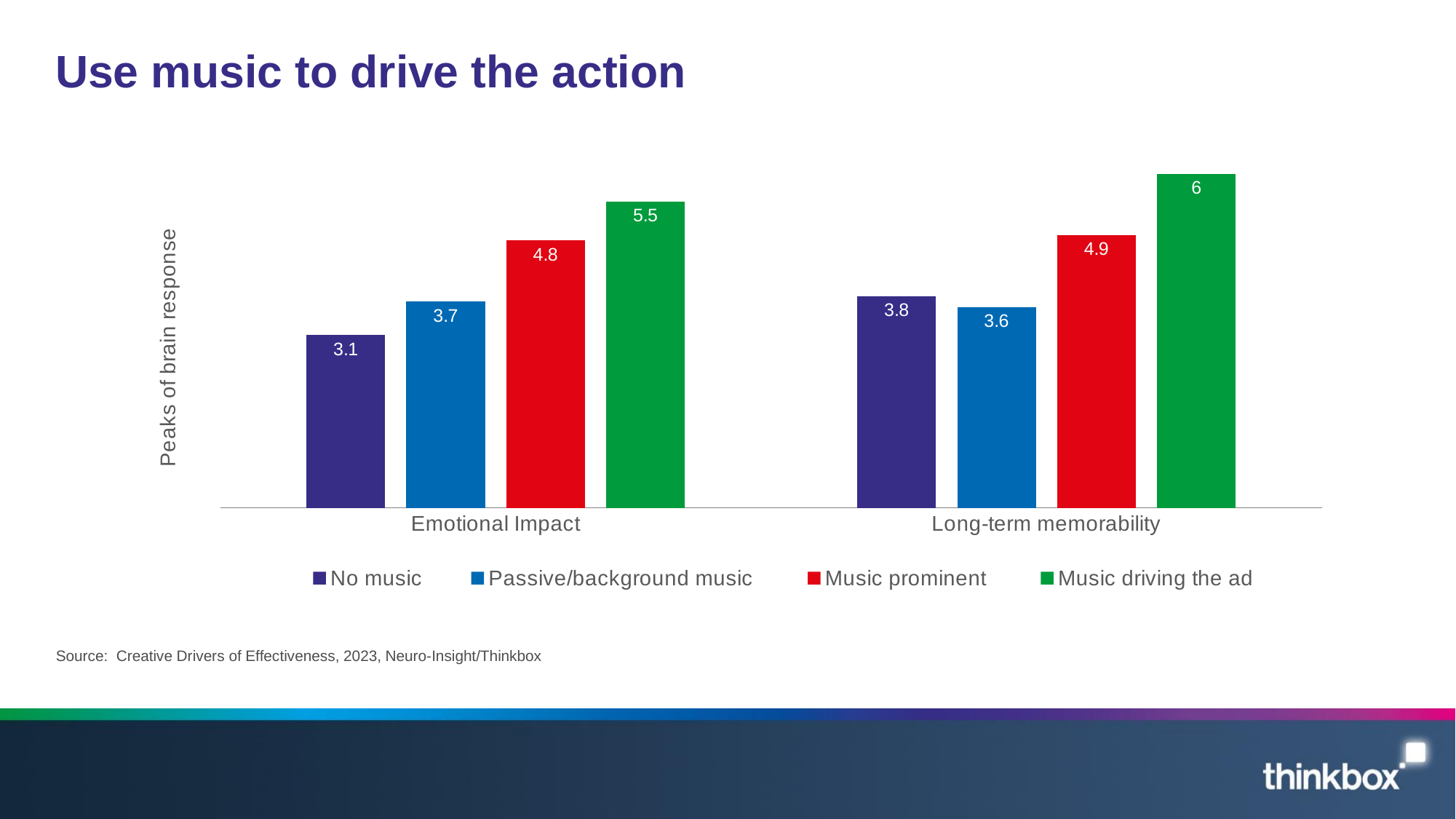
What is the difference between Music driving the ad and Music prominent under Long-term memorability? 1.1 Which series has the lowest value under Long-term memorability? Passive/background music What kind of chart is shown on the slide? Bar chart What is the value for No music under Emotional Impact? 3.1 What is the value for Music prominent under Emotional Impact? 4.8 What is the value for Passive/background music under Long-term memorability? 3.6 What is the value for Music driving the ad under Long-term memorability? 6 How many series does the legend list? 4 What is the label on the vertical axis of the chart? Peaks of brain response Which is larger under Long-term memorability: No music or Passive/background music? No music What is the difference between Music driving the ad and No music under Emotional Impact? 2.4 Which series has the highest value under Emotional Impact? Music driving the ad